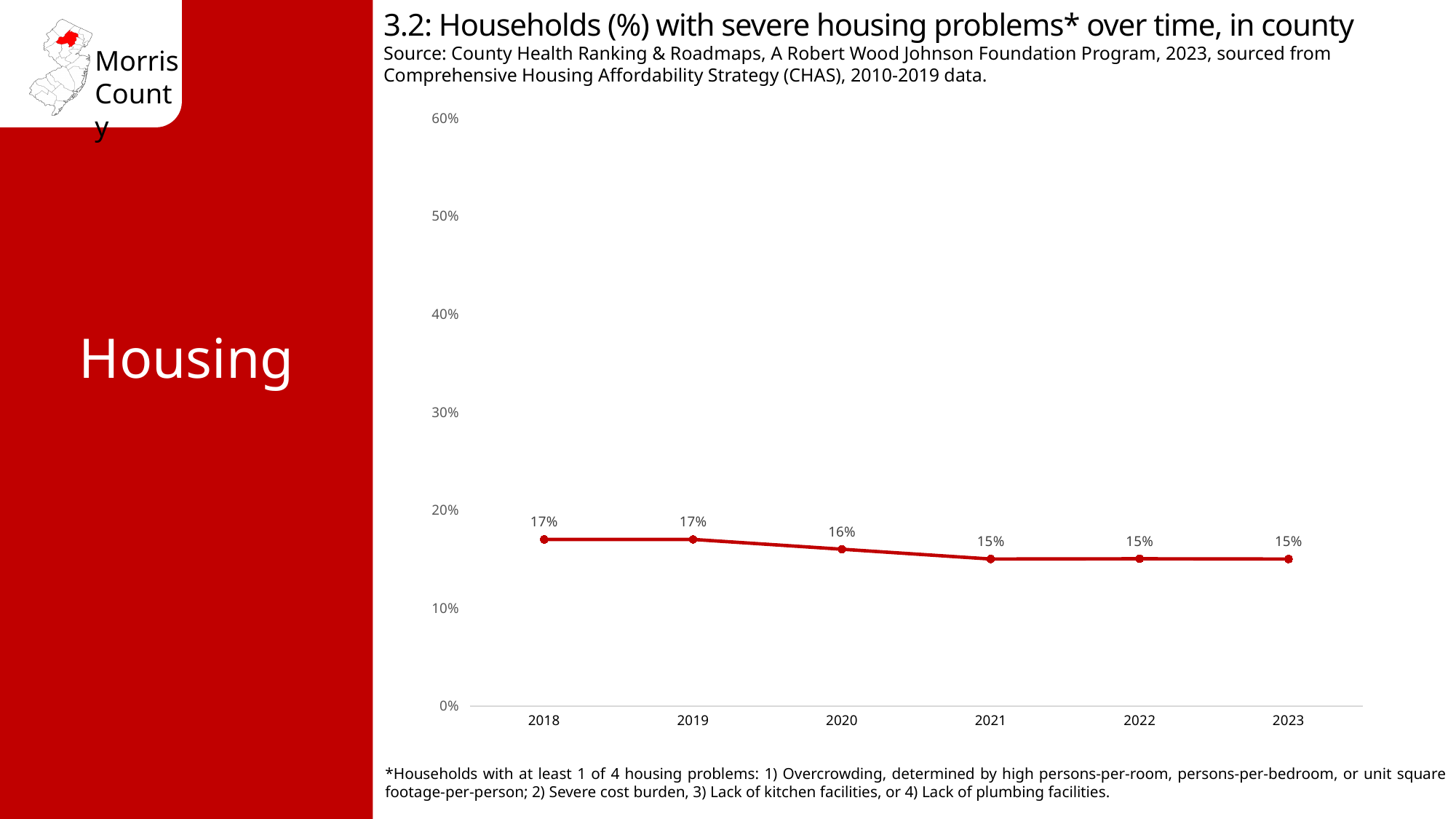
Which is larger, the value for 2019 or the value for 2021? 2019 How many years are plotted on the chart? 6 What percentage of households had severe housing problems in 2018? 17% Is the value for 2020 greater or less than 20%? less What is the value shown for 2020? 16% What is the highest value shown on the y axis? 60% What is the difference between the 2018 value and the 2023 value? 2% What kind of chart is shown on the slide? line chart What is the value shown for 2021? 15% What is the difference between the 2019 value and the 2020 value? 1% Do the values rise or fall from 2018 to 2023? fall What percentage of households had severe housing problems in 2023? 15%